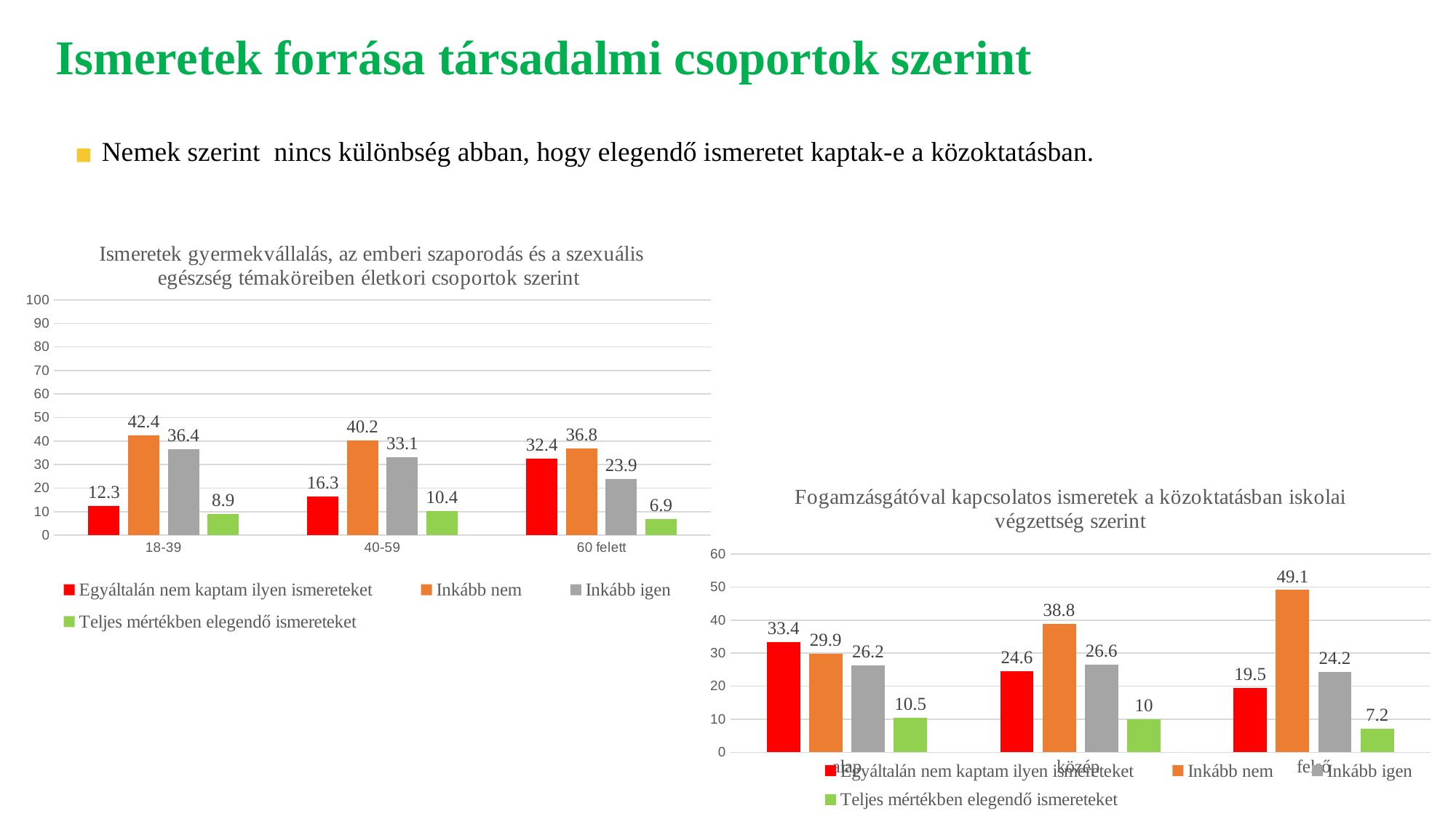
What type of chart is the right chart (iskolai végzettség szerint)? Bar chart In the left chart (életkori csoportok szerint), which age group has the highest value for 'Teljes mértékben elegendő ismereteket'? 40-59 In the right chart (iskolai végzettség szerint), how many series does the legend list? 4 In the left chart (életkori csoportok szerint), what is the value of 'Egyáltalán nem kaptam ilyen ismereteket' for the '60 felett' group? 32.4 In the left chart (életkori csoportok szerint), how many age groups are shown on the x axis? 3 In the left chart (életkori csoportok szerint), what is the difference between the 'Inkább nem' values for 18-39 and 40-59? 2.2 In the right chart (iskolai végzettség szerint), is the 'Inkább nem' value for 'alap' larger or smaller than the 'Inkább nem' value for 'közép'? smaller In the left chart (életkori csoportok szerint), which age group has the lowest value for 'Inkább igen'? 60 felett In the right chart (iskolai végzettség szerint), which education level has the highest value for 'Egyáltalán nem kaptam ilyen ismereteket'? alap In the right chart (Fogamzásgátóval kapcsolatos ismeretek... iskolai végzettség szerint), what is the value of 'Inkább nem' for 'felső'? 49.1 In the left chart (Ismeretek gyermekvállalás... életkori csoportok szerint), what is the value of 'Inkább nem' for the 18-39 age group? 42.4 In the right chart (iskolai végzettség szerint), what is the value of 'Teljes mértékben elegendő ismereteket' for 'közép'? 10